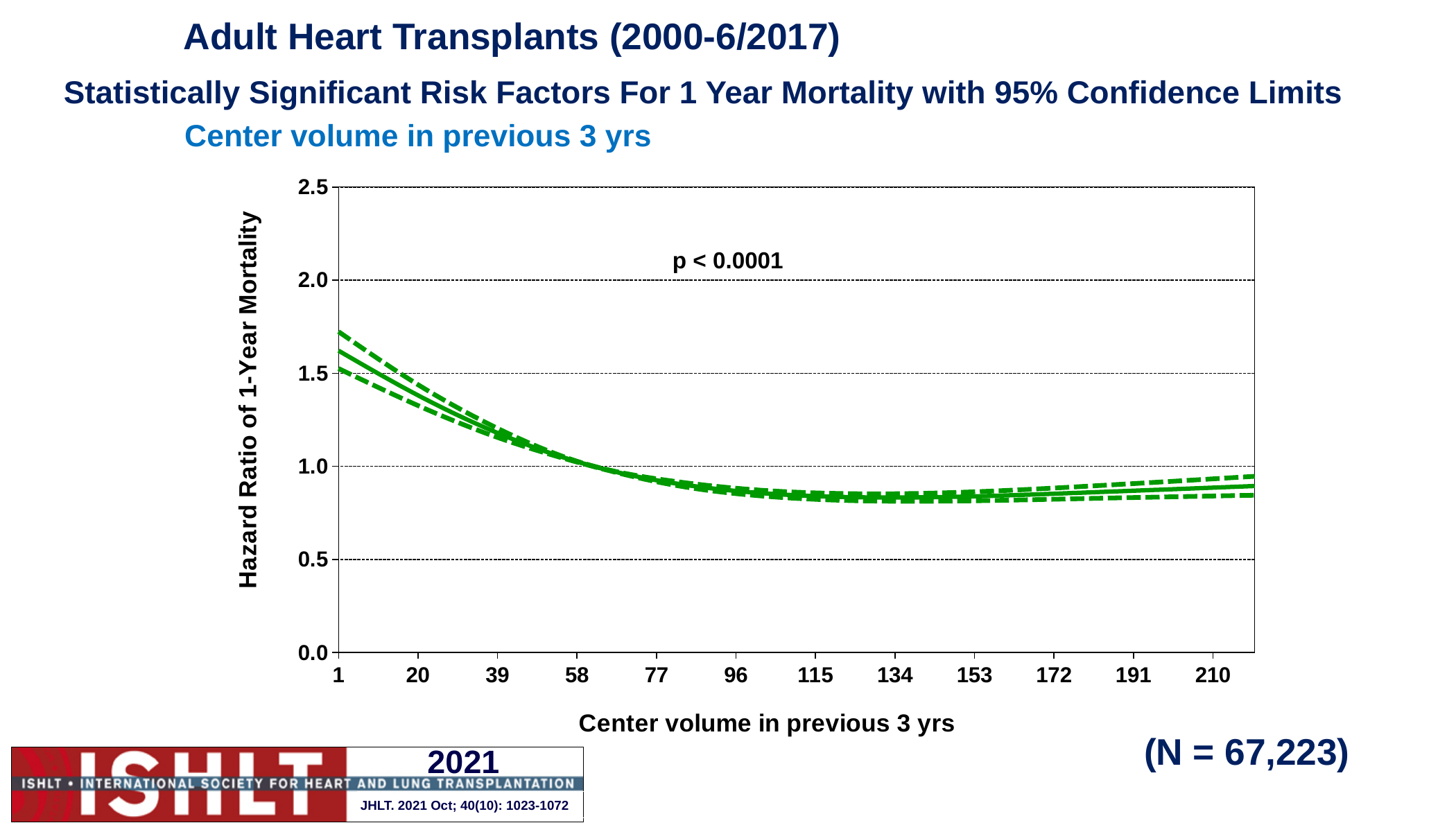
Is the hazard ratio at a center volume of 115 greater or less than 1.0? less Is the hazard ratio at a center volume of 20 greater or less than 1.0? greater What is the title of the y axis? Hazard Ratio of 1-Year Mortality What kind of chart is shown on the slide? line chart At which center volume shown on the x axis is the hazard ratio highest? 1 Is the hazard ratio at a center volume of 210 greater or less than 1.0? less Does the hazard ratio rise or fall as center volume increases from 1 to 96? fall What p-value is printed on the chart? p < 0.0001 Which has the larger hazard ratio: a center volume of 1 or a center volume of 134? 1 What is the highest value shown on the y axis? 2.5 How many tick labels are shown on the x axis? 12